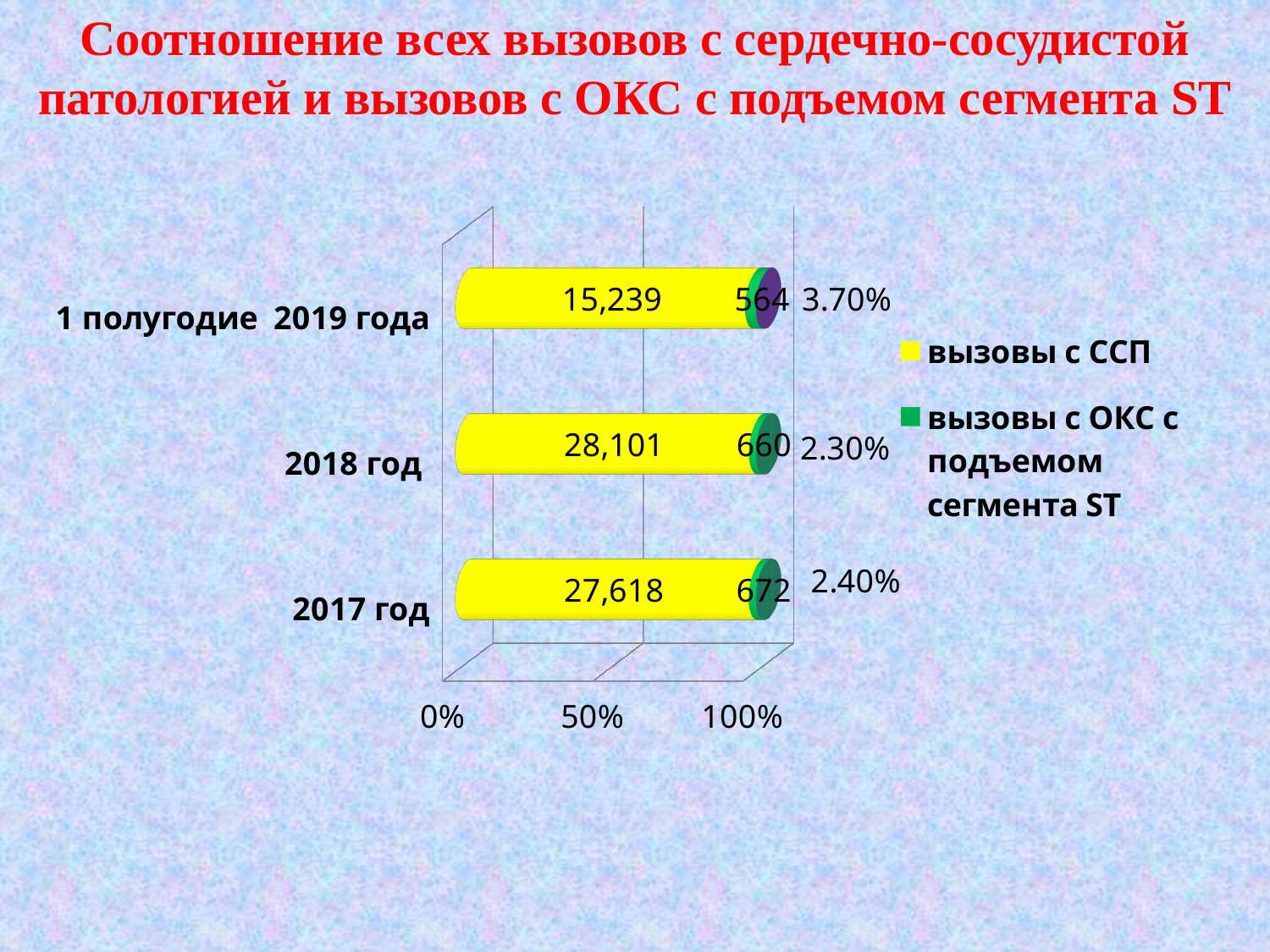
What percentage is shown next to the bar for 2018 год? 2.30% What is the value for "вызовы с ОКС с подъемом сегмента ST" in 2017 год? 672 What percentage is shown next to the bar for 1 полугодие 2019 года? 3.70% Which category has the lowest value for "вызовы с ОКС с подъемом сегмента ST"? 1 полугодие 2019 года What is the difference between the "вызовы с ССП" values for 2018 год and 2017 год? 483 What is the value for "вызовы с ОКС с подъемом сегмента ST" in 1 полугодие 2019 года? 564 What is the value for "вызовы с ССП" in 2018 год? 28,101 What is the value for "вызовы с ССП" in 1 полугодие 2019 года? 15,239 Which category has the highest value for "вызовы с ССП"? 2018 год How many categories are shown on the chart? 3 What is the value for "вызовы с ССП" in 2017 год? 27,618 How many series does the legend list? 2